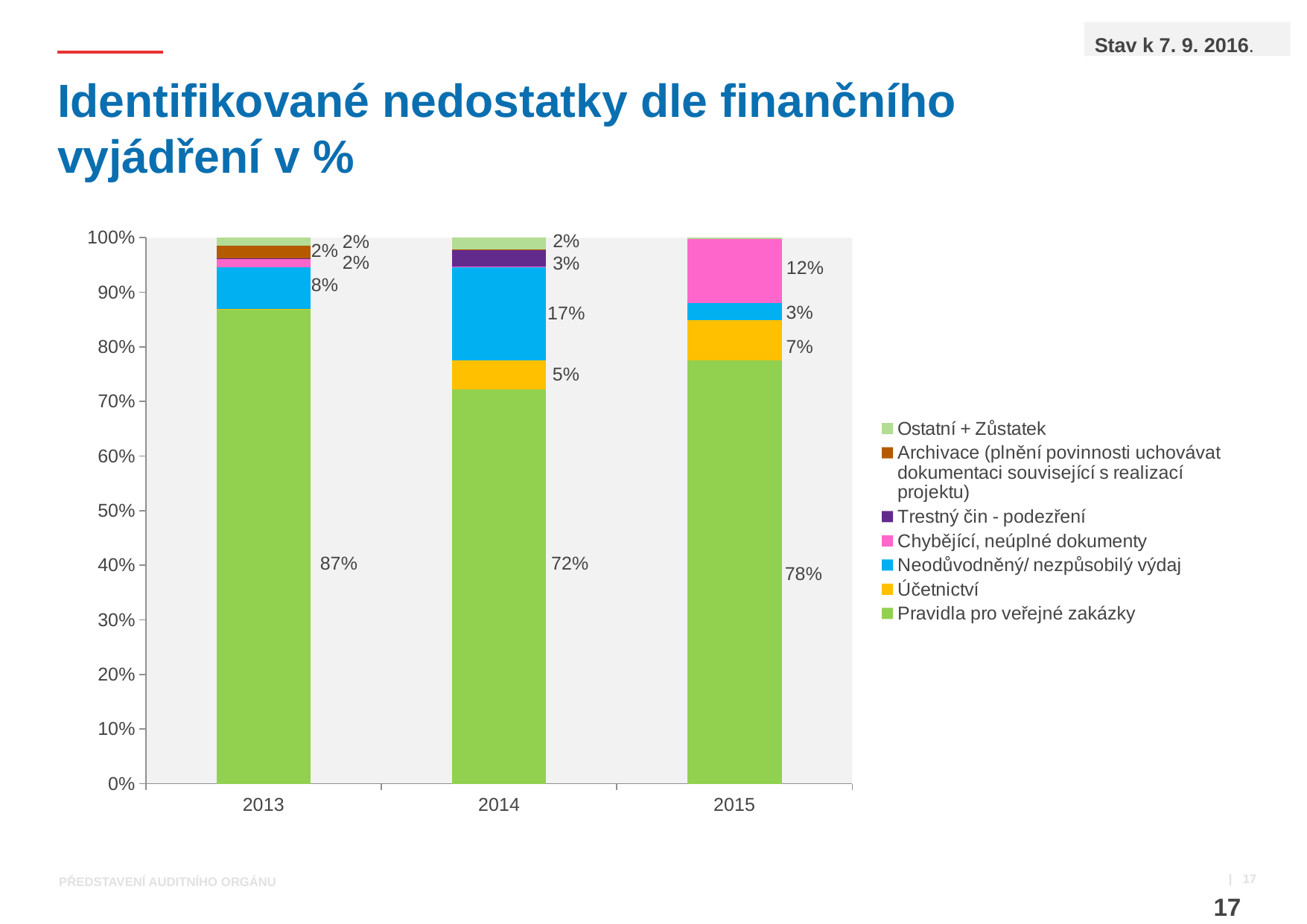
What is the value for Chybějící, neúplné dokumenty in 2015? 12% What is the value for Neodůvodněný/ nezpůsobilý výdaj in 2014? 17% What is the value for Účetnictví in 2015? 7% How many years are shown on the x axis? 3 How many series does the legend list? 7 In which year is the share of Pravidla pro veřejné zakázky the highest? 2013 Which year has the larger share for Účetnictví, 2014 or 2015? 2015 What kind of chart is shown on the slide? Stacked bar chart What is the value for Trestný čin - podezření in 2014? 3% In which year is the share of Pravidla pro veřejné zakázky the lowest? 2014 What is the value for Pravidla pro veřejné zakázky in 2013? 87% What is the difference between the Neodůvodněný/ nezpůsobilý výdaj share in 2014 and in 2015? 14 percentage points